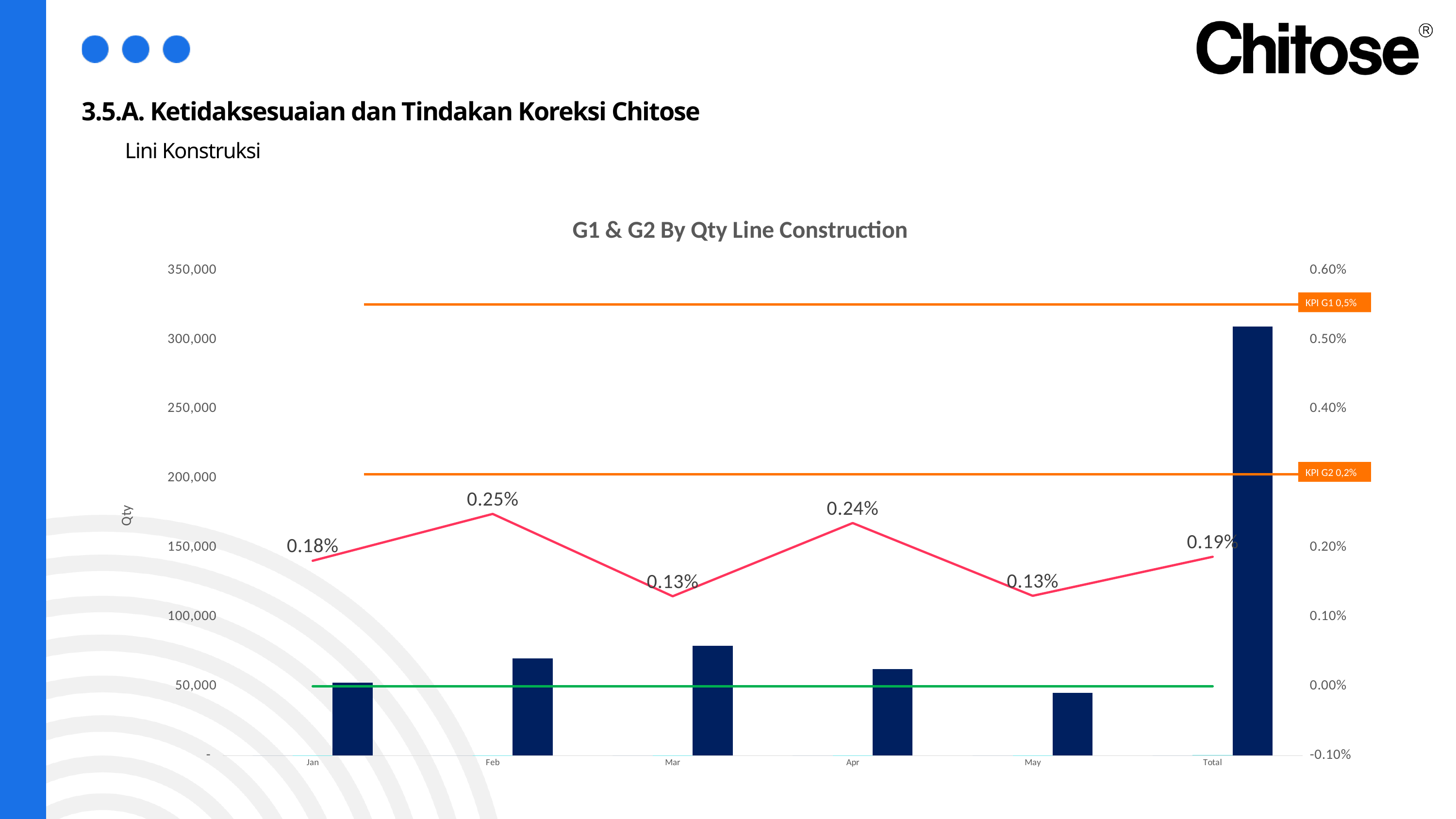
Which category has the highest percentage value on the line? Feb What is the title of the chart? G1 & G2 By Qty Line Construction What percentage value is labelled on the line for Jan? 0.18% What value is shown on the KPI G1 label? 0,5% How many categories are shown on the x axis? 6 What is the difference between the percentage values for Feb and Mar? 0.12% Is the Qty bar for Mar greater or less than 100,000? less What percentage value is labelled on the line for Feb? 0.25% Is the Qty bar for May greater or less than 50,000? less Is the Qty bar for Total greater or less than 300,000? greater Which has the larger percentage value on the line, Apr or Jan? Apr What percentage value is labelled on the line for Total? 0.19%